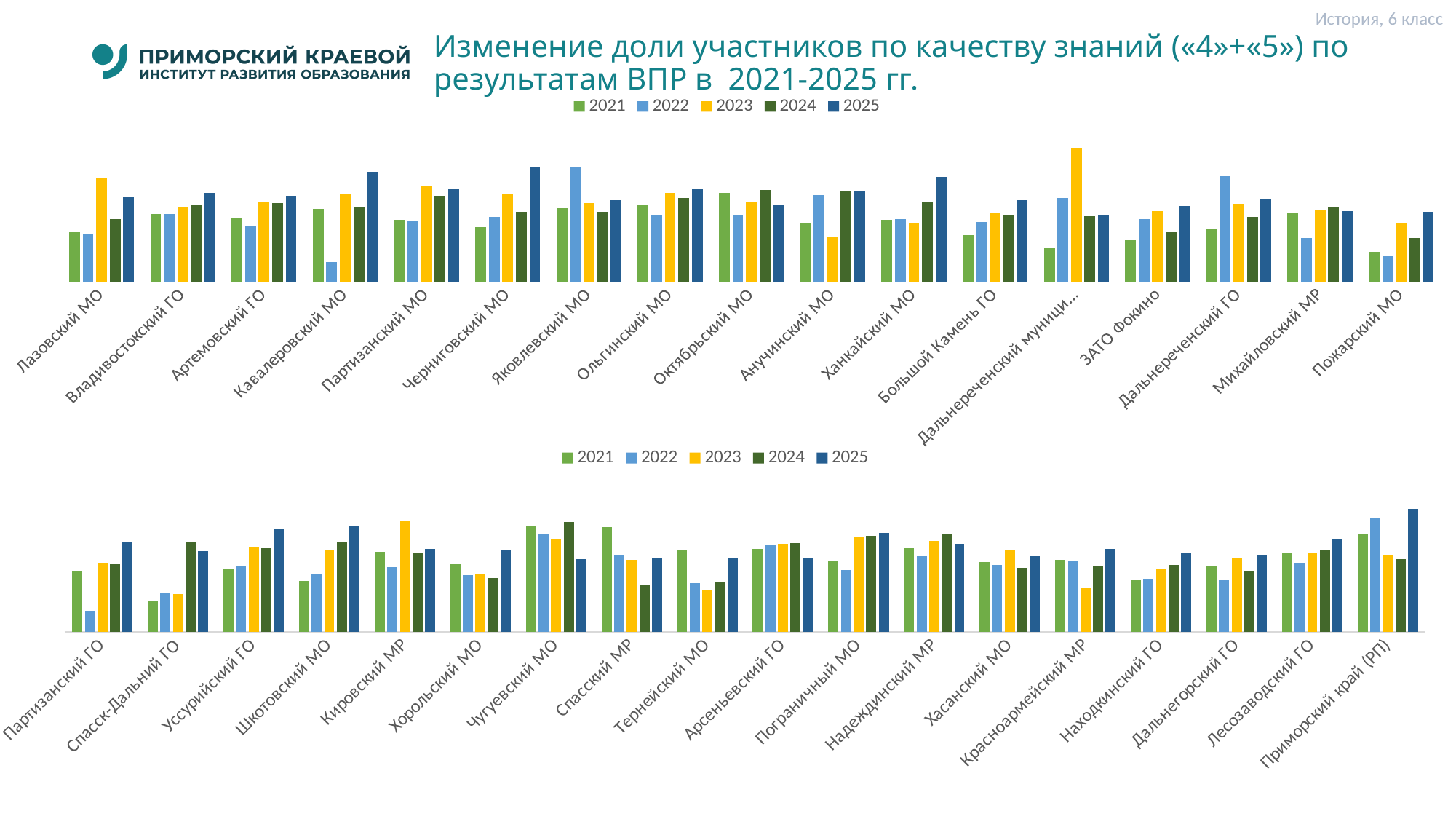
Which year is shown in yellow in the legend of the charts? 2023 What kind of chart is the top chart on the slide? bar chart How many series does the legend of the top chart list? 5 In the bottom chart, is the 2021 bar or the 2024 bar taller for Спасск-Дальний ГО? 2024 In the top chart, which year has the tallest bar for Яковлевский МО? 2022 In the bottom chart, which year has the tallest bar for Кировский МР? 2023 How many categories are shown on the x axis of the top chart? 17 How many categories are shown on the x axis of the bottom chart? 18 In the bottom chart, which category and year has the tallest bar? Приморский край (РП), 2025 In the bottom chart, which year has the shortest bar for Партизанский ГО? 2022 In the top chart, which year has the shortest bar for Кавалеровский МО? 2022